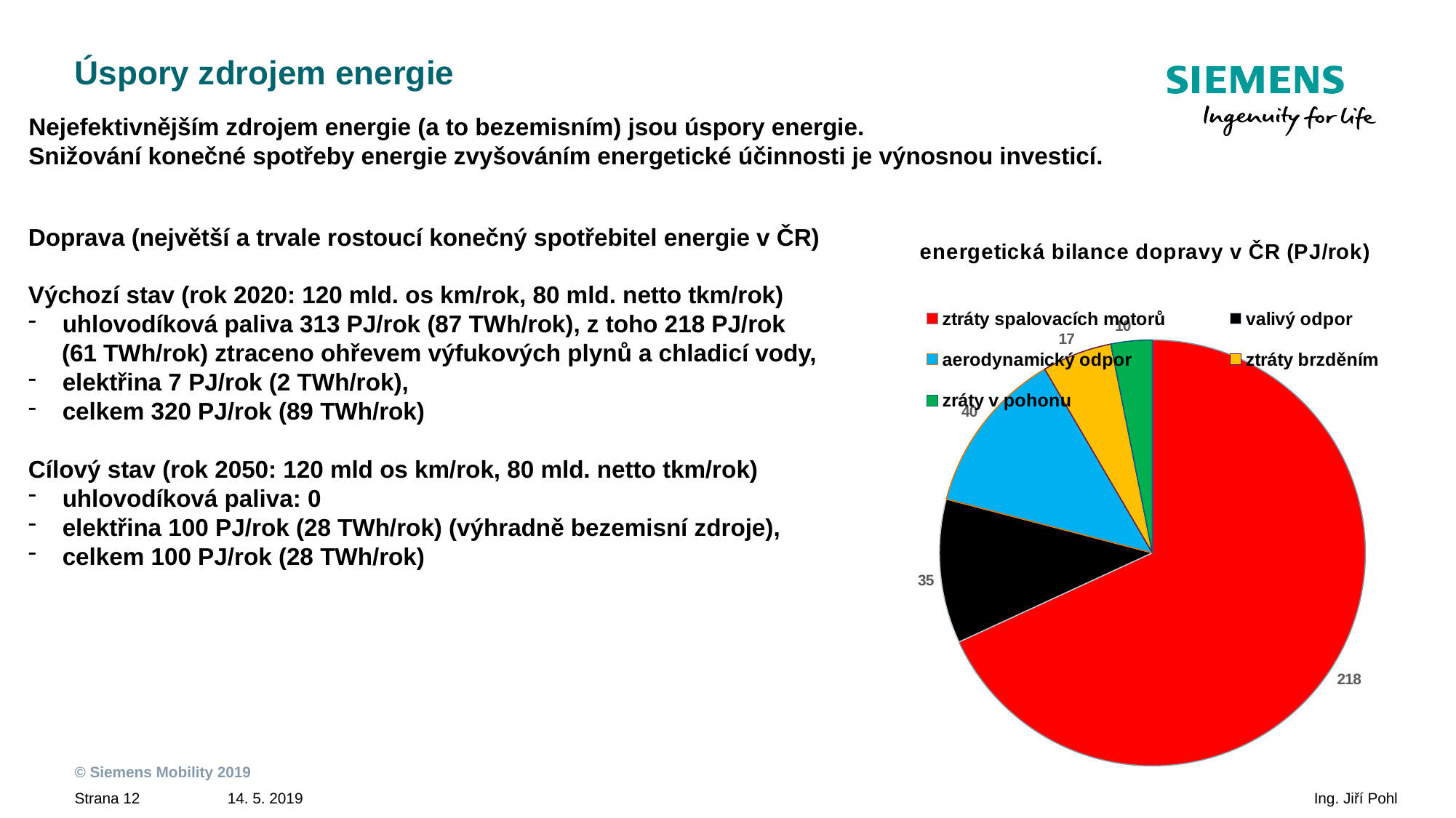
Which category has the smallest slice in the pie chart? zráty v pohonu What is the value for ztráty spalovacích motorů in the pie chart? 218 What is the value for aerodynamický odpor in the pie chart? 40 What is the title of the pie chart? energetická bilance dopravy v ČR (PJ/rok) Which category has the largest slice in the pie chart? ztráty spalovacích motorů How many categories does the pie chart show? 5 What is the value for valivý odpor in the pie chart? 35 Which is larger in the pie chart, aerodynamický odpor or valivý odpor? aerodynamický odpor What kind of chart is shown on the slide? pie chart What is the value for ztráty brzděním in the pie chart? 17 What is the difference between the values for ztráty spalovacích motorů and valivý odpor? 183 What is the difference between the values for aerodynamický odpor and ztráty brzděním? 23